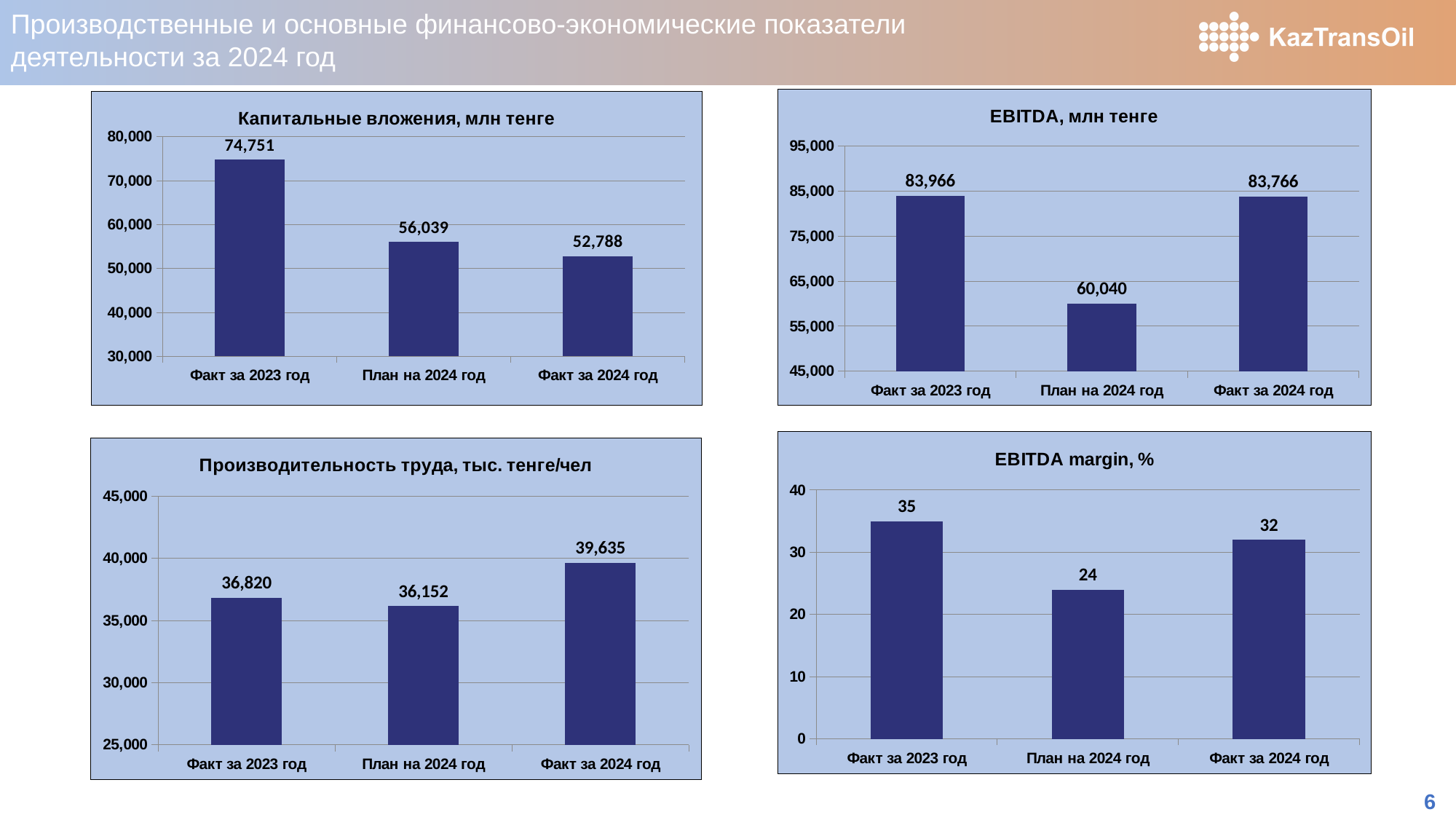
In the chart titled "Капитальные вложения, млн тенге", which category has the lowest value? Факт за 2024 год In the chart titled "Производительность труда, тыс. тенге/чел", which is larger: "Факт за 2023 год" or "План на 2024 год"? Факт за 2023 год In the chart titled "EBITDA, млн тенге", which category has the highest value? Факт за 2023 год In the chart titled "Капитальные вложения, млн тенге", what is the value for "Факт за 2023 год"? 74,751 How many categories are shown in the chart titled "EBITDA margin, %"? 3 What kind of chart is the chart titled "Производительность труда, тыс. тенге/чел"? Bar chart In the chart titled "EBITDA margin, %", what is the difference between "Факт за 2024 год" and "План на 2024 год"? 8 In the chart titled "EBITDA, млн тенге", what is the difference between "Факт за 2024 год" and "План на 2024 год"? 23,726 In the chart titled "EBITDA, млн тенге", what is the value for "План на 2024 год"? 60,040 In the chart titled "EBITDA margin, %", what is the value for "Факт за 2023 год"? 35 In the chart titled "Капитальные вложения, млн тенге", what is the difference between "План на 2024 год" and "Факт за 2024 год"? 3,251 In the chart titled "Производительность труда, тыс. тенге/чел", what is the value for "Факт за 2024 год"? 39,635